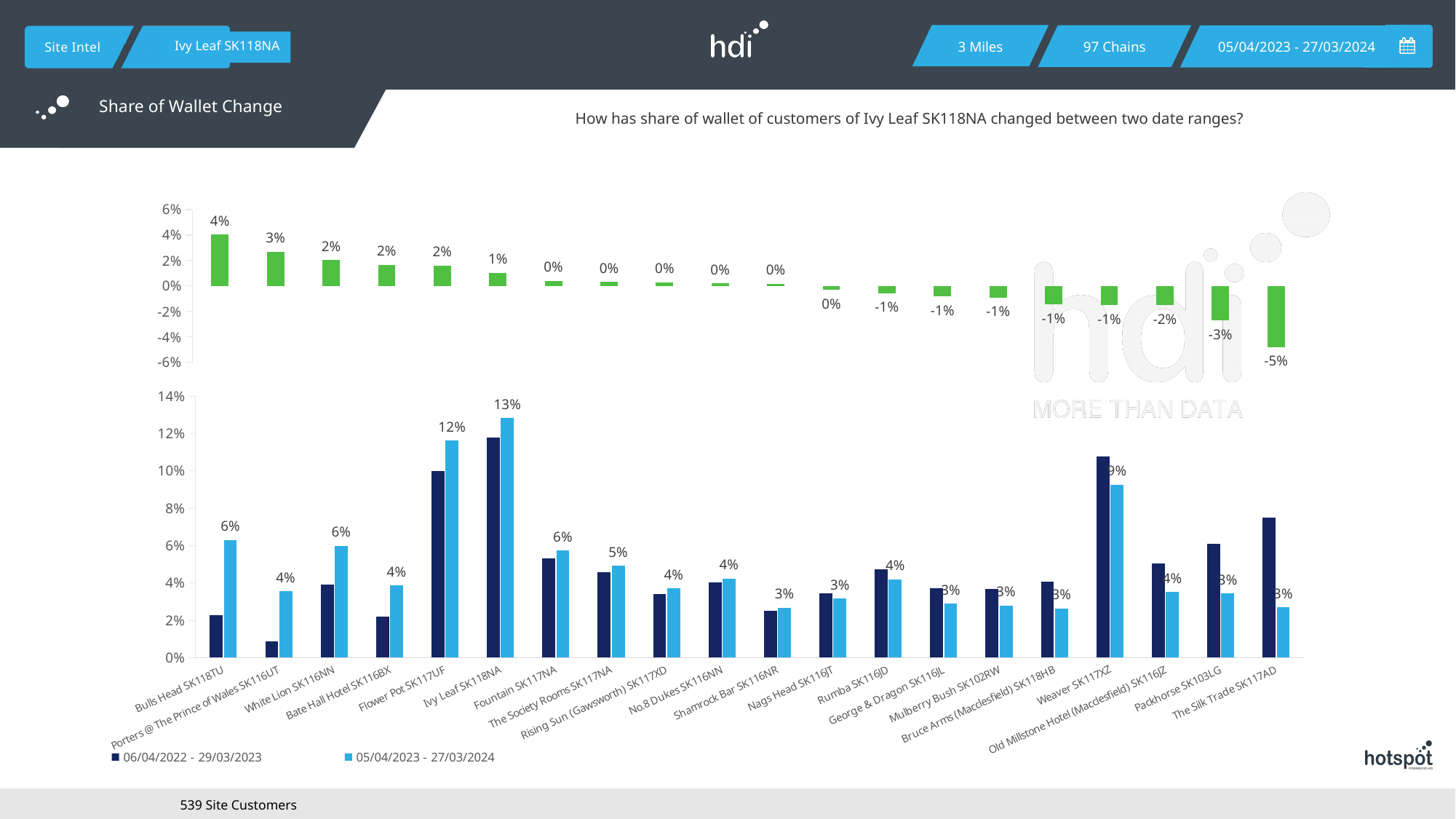
In the bottom chart, which category has the highest 05/04/2023 - 27/03/2024 value? Ivy Leaf SK118NA How many categories are shown on the x axis of the bottom chart? 20 In the top chart (share of wallet change), what is the value for Packhorse SK103LG? -3% In the top chart (share of wallet change), what is the value for Bulls Head SK118TU? 4% What kind of chart is the bottom chart? Bar chart In the bottom chart, what is the difference between the 05/04/2023 - 27/03/2024 values for Ivy Leaf SK118NA and Flower Pot SK117UF? 1% In the top chart (share of wallet change), which category has the lowest value? The Silk Trade SK117AD In the bottom chart, what is the 05/04/2023 - 27/03/2024 value for Ivy Leaf SK118NA? 13% In the top chart (share of wallet change), which category has the highest value? Bulls Head SK118TU In the bottom chart, which has the larger 05/04/2023 - 27/03/2024 value: Bulls Head SK118TU or Porters @ The Prince of Wales SK116UT? Bulls Head SK118TU In the bottom chart, is the 06/04/2022 - 29/03/2023 value for Weaver SK117XZ greater or less than 10%? greater How many series does the legend of the bottom chart list? 2